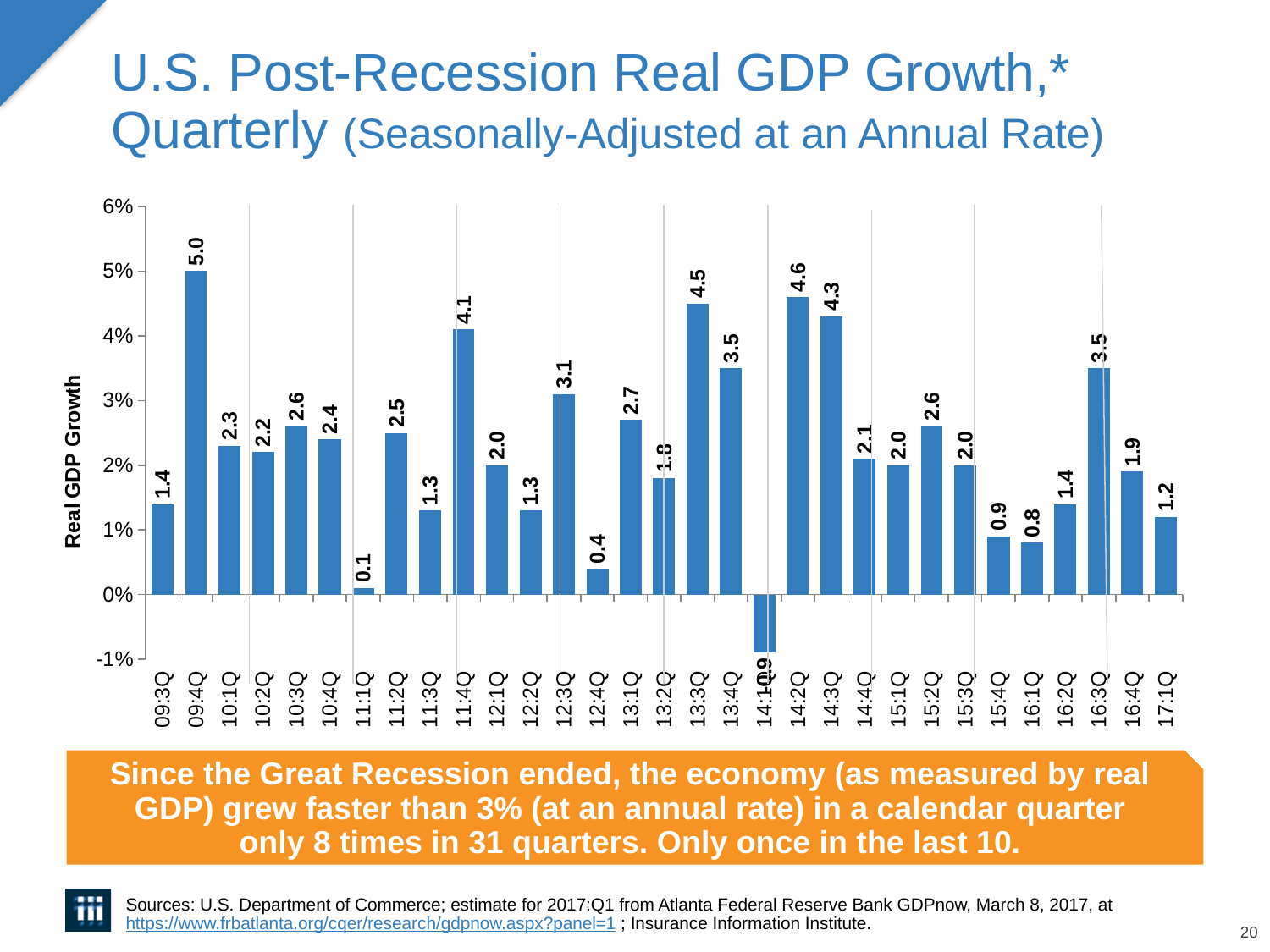
What is the real GDP growth value for 17:1Q? 1.2 Is the value for 14:1Q greater or less than 0%? less Which quarter has the larger real GDP growth, 11:4Q or 12:3Q? 11:4Q What is the real GDP growth value for 16:3Q? 3.5 What is the real GDP growth value for 09:4Q? 5.0 What is the label on the vertical axis of the chart? Real GDP Growth What is the real GDP growth value for 11:1Q? 0.1 What kind of chart is shown on the slide? bar chart How many quarters are plotted on the chart? 31 What is the difference between the real GDP growth values for 09:4Q and 14:2Q? 0.4 Which quarter has the highest real GDP growth? 09:4Q Which quarter has the lowest real GDP growth? 14:1Q